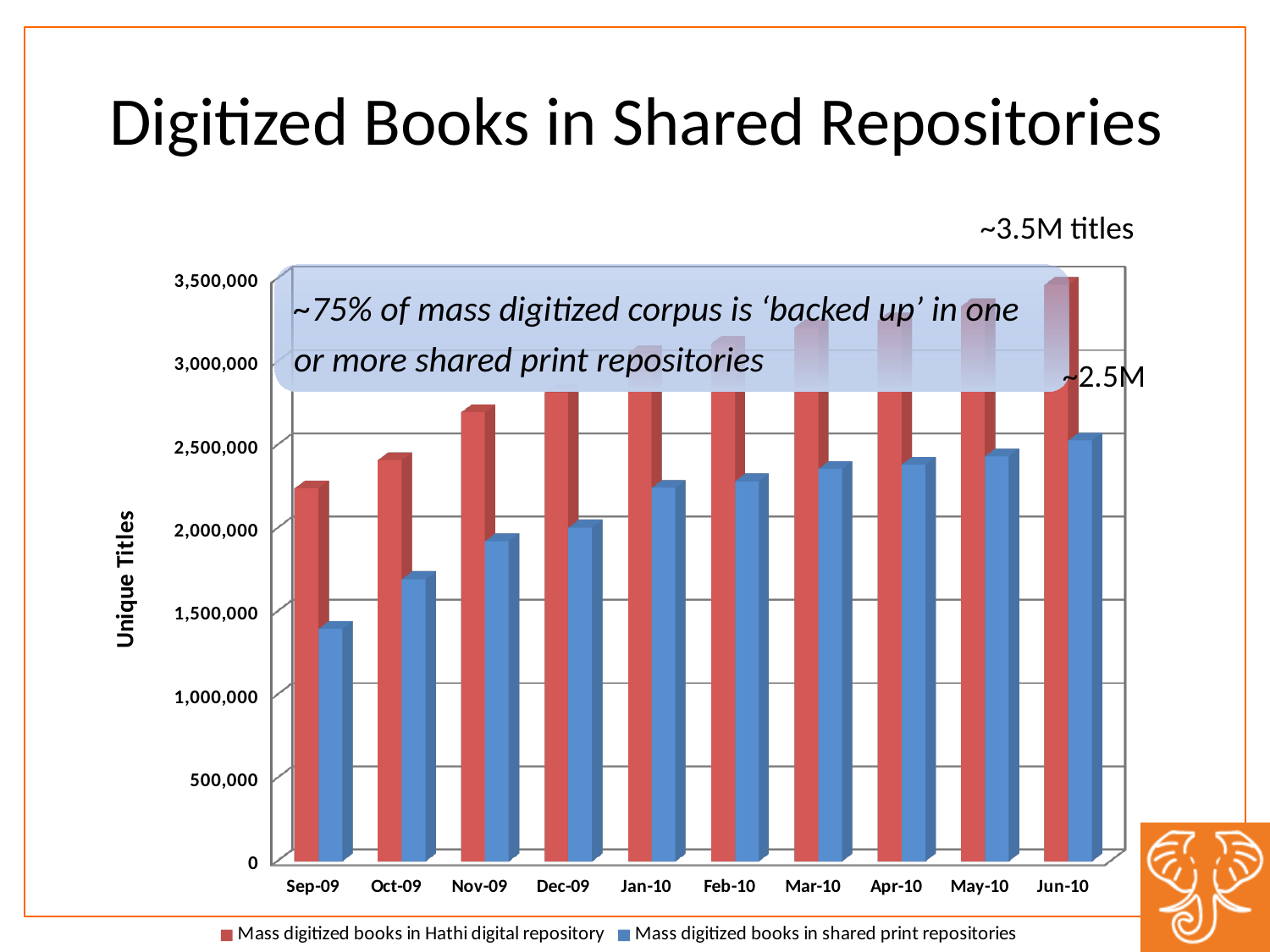
How many months are shown on the x axis of the chart? 10 Do the values for mass digitized books in shared print repositories rise or fall from Sep-09 to Jun-10? Rise Is the value for mass digitized books in shared print repositories in Jan-10 greater or less than 2,000,000? greater How many series does the chart legend list? 2 What kind of chart is shown on the slide? Bar chart Which month has the highest value for mass digitized books in Hathi digital repository? Jun-10 Is the value for mass digitized books in Hathi digital repository in Nov-09 greater or less than 2,500,000? greater Which month has the lowest value for mass digitized books in shared print repositories? Sep-09 Is the value for mass digitized books in shared print repositories in Sep-09 greater or less than 1,500,000? less In Sep-09, which is larger: mass digitized books in Hathi digital repository or mass digitized books in shared print repositories? Mass digitized books in Hathi digital repository What is the label on the vertical axis of the chart? Unique Titles